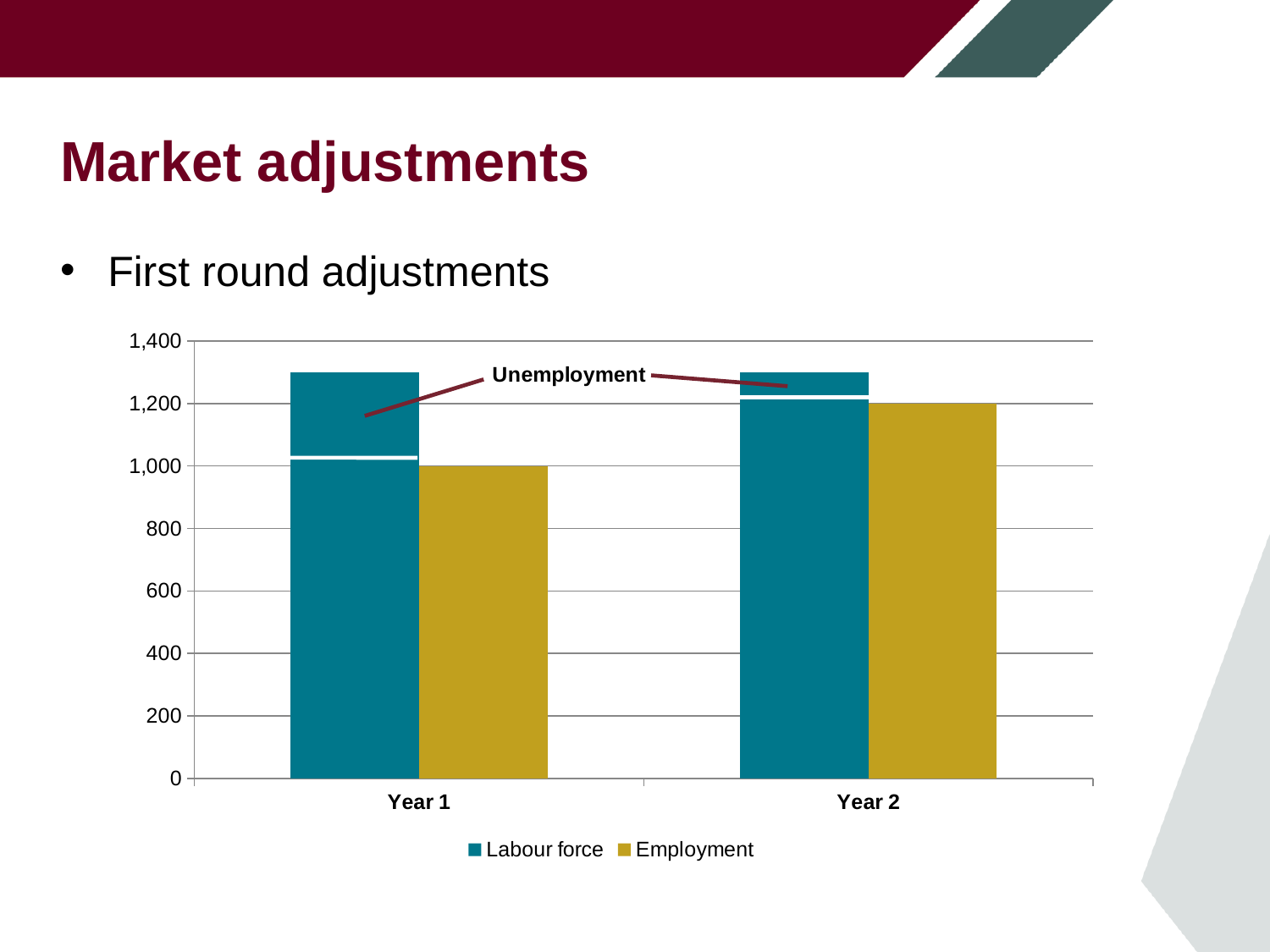
In Year 2, which is larger: Labour force or Employment? Labour force In Year 1, which is larger: Labour force or Employment? Labour force What is the difference between the Employment values for Year 2 and Year 1? 200 What is the Employment value for Year 2? 1,200 Does Employment rise or fall from Year 1 to Year 2? Rise Is the Labour force value for Year 1 greater or less than 1,200? greater What label does the annotation pointing to the gap between the Labour force and Employment bars show? Unemployment Is the Labour force value for Year 2 greater or less than 1,400? less What is the Employment value for Year 1? 1,000 How many series does the legend list? 2 How many categories are shown on the x axis? 2 What kind of chart is shown on the slide? Bar chart